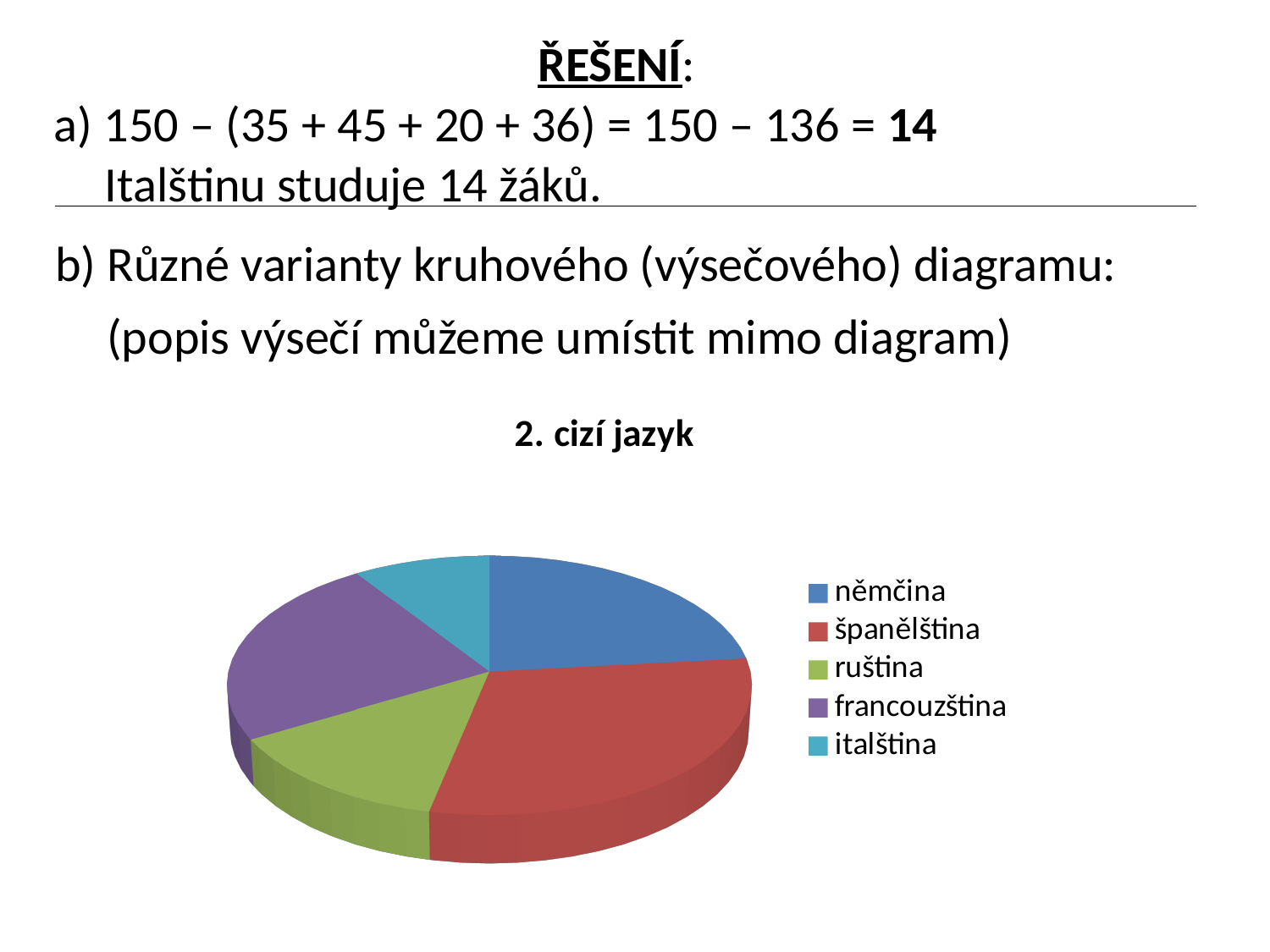
Which language has the largest slice of the pie? španělština What is the title of the chart? 2. cizí jazyk How many entries does the legend list? 5 Which language is shown in red in the pie chart? španělština Which slice is larger, němčina or ruština? němčina Which slice is larger, francouzština or italština? francouzština Which slice is larger, ruština or italština? ruština How many slices does the pie chart have? 5 Which language has the smallest slice of the pie? italština What kind of chart is shown on the slide? pie chart